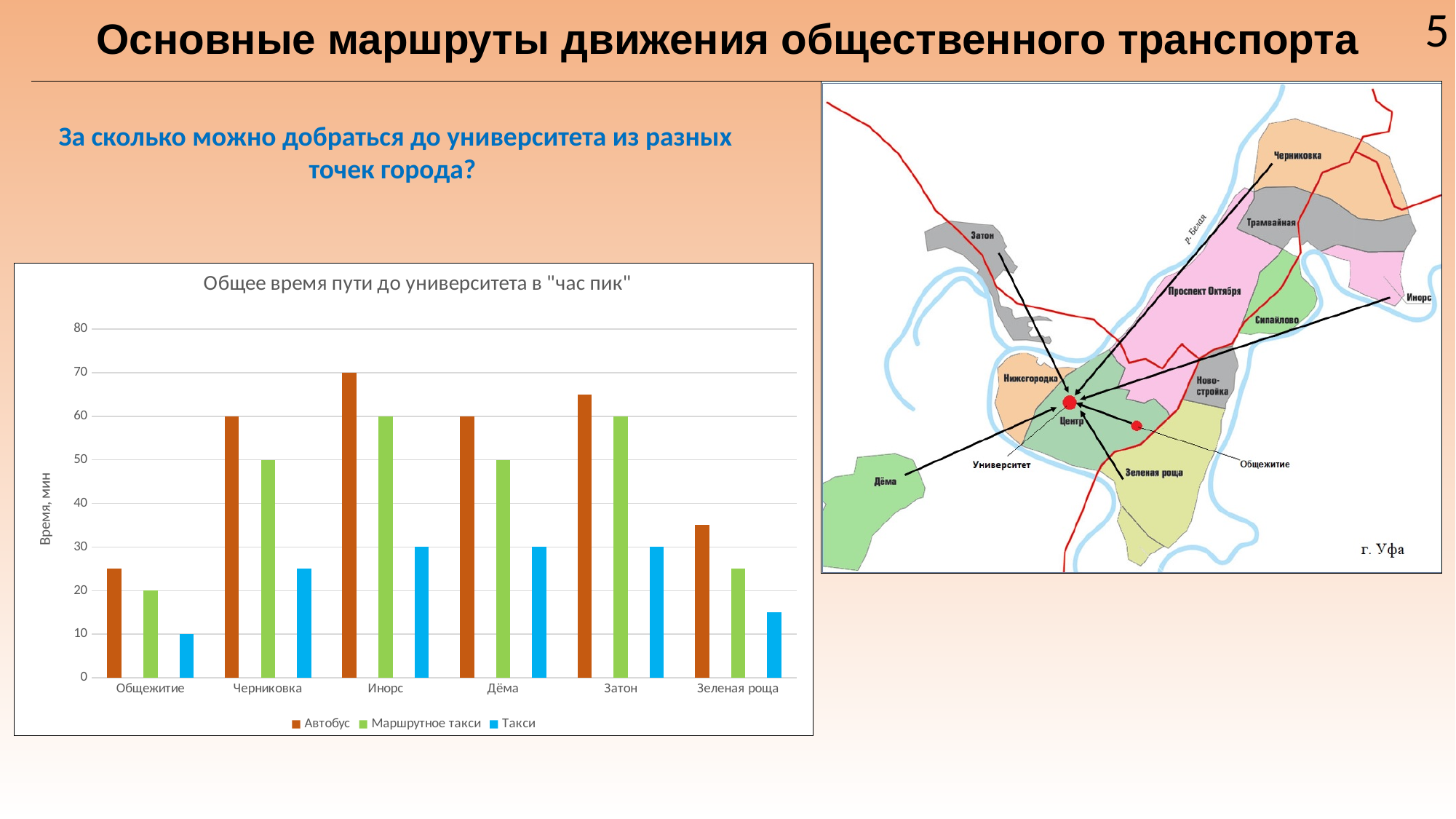
What is the title of the chart? Общее время пути до университета в "час пик" Is the Такси value for Зеленая роща greater or less than 20? less Which category has the lowest Такси value? Общежитие Is the Автобус value for Затон greater or less than 60? greater How many categories are shown on the x axis of the chart? 6 How many series does the chart legend list? 3 Which category has the highest Автобус value? Инорс What is the value for Такси for Общежитие? 10 What type of chart is shown on the slide? bar chart Which is larger for Дёма: the Автобус value or the Такси value? Автобус What is the value for Автобус for Инорс? 70 What is the value for Маршрутное такси for Черниковка? 50